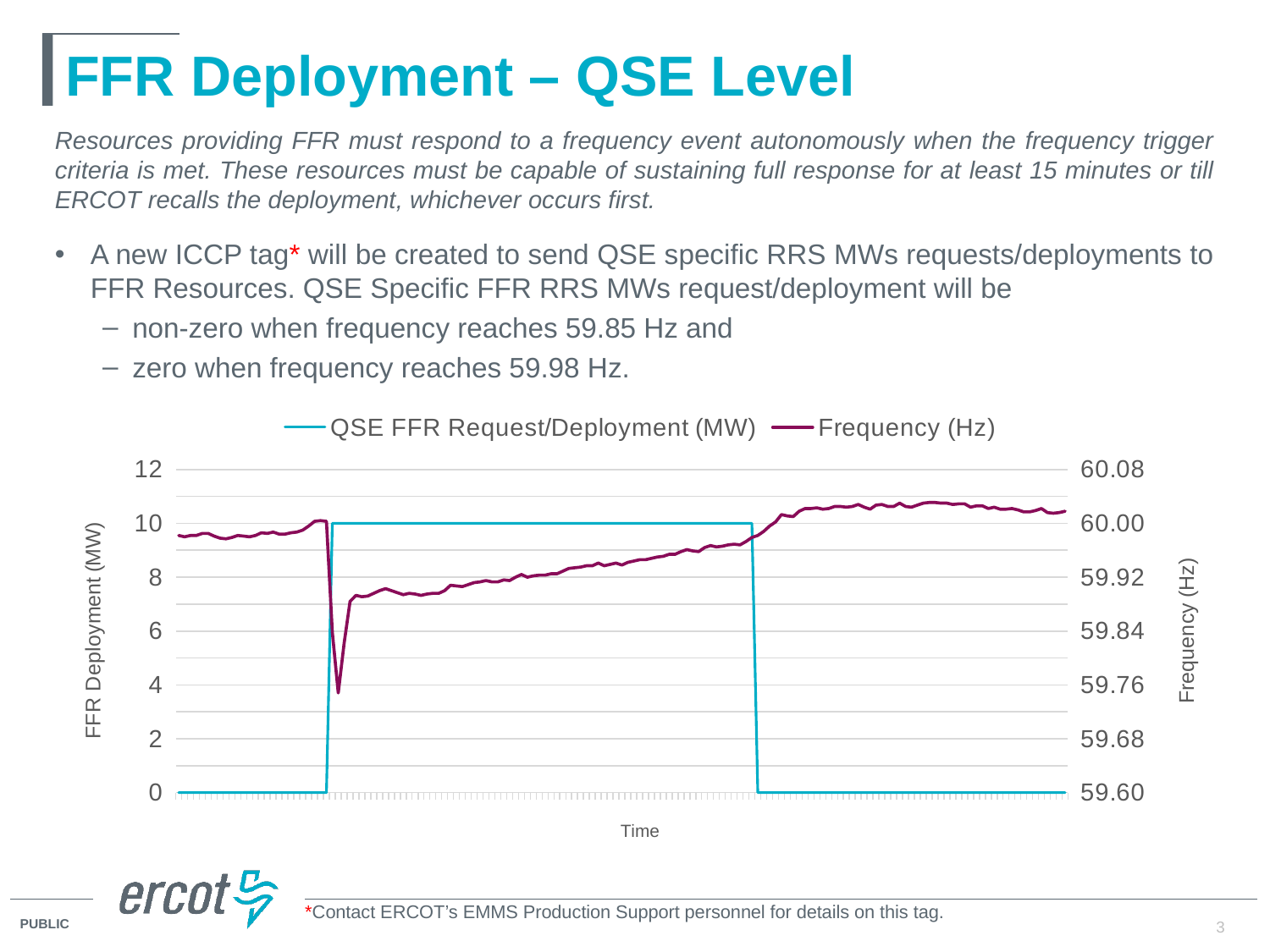
What is the highest tick value shown on the right-hand Frequency (Hz) axis? 60.08 What are the two series named in the chart legend? QSE FFR Request/Deployment (MW) and Frequency (Hz) What is the value of the QSE FFR Request/Deployment (MW) line before the frequency event begins? 0 After its sharp dip, does the Frequency (Hz) line rise or fall as time moves to the right? rise What kind of chart is shown on the slide? line chart Is the lowest value of the Frequency (Hz) line greater or less than 59.84? less What value does the QSE FFR Request/Deployment (MW) line hold while the deployment is active? 10 What is the title of the left vertical axis of the chart? FFR Deployment (MW) How many series does the chart legend list? 2 Is the Frequency (Hz) value at the start of the chart greater or less than 59.92? greater Is the QSE FFR Request/Deployment (MW) value during the deployment greater or less than 8? greater